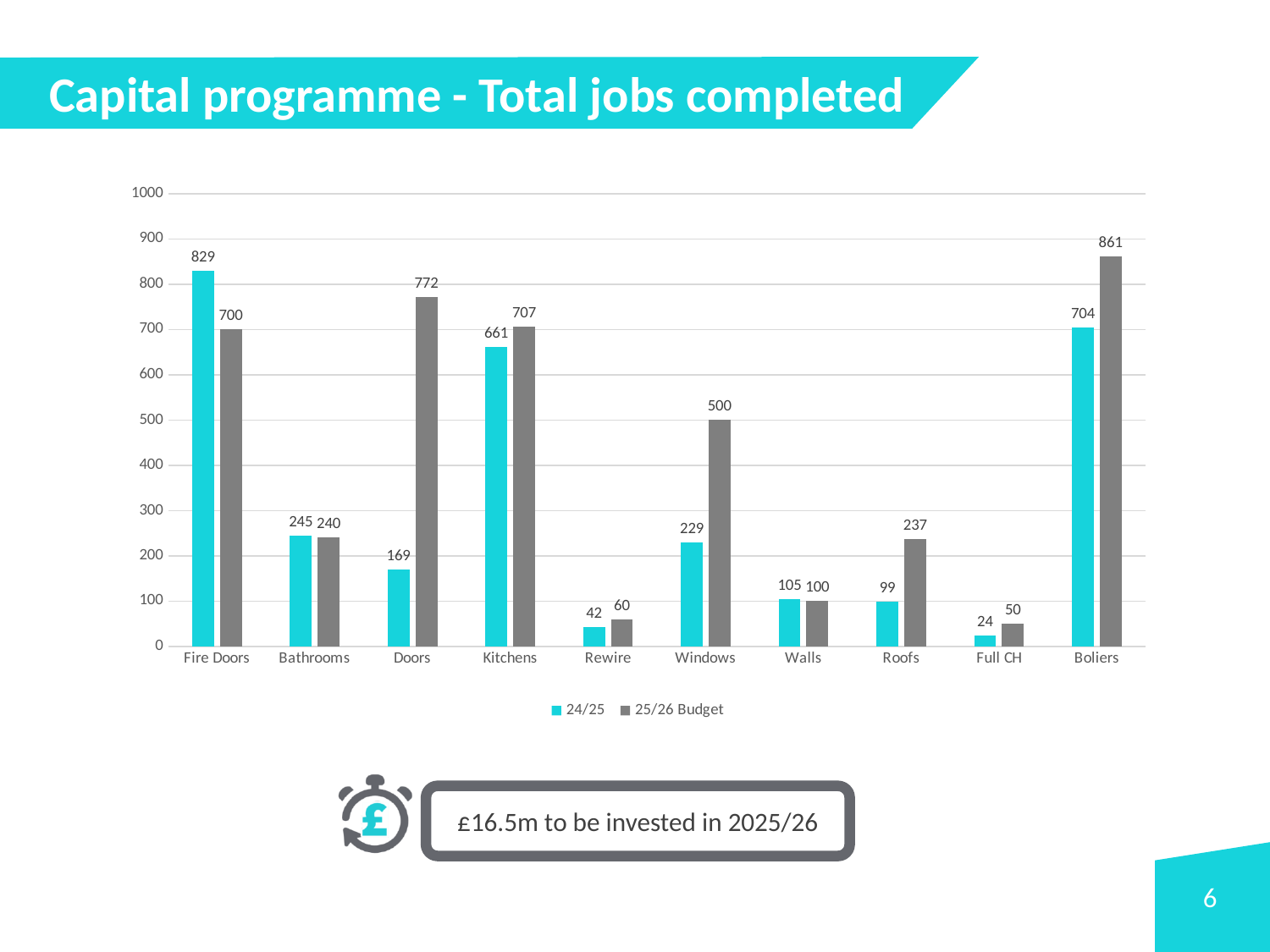
Which category has the highest 25/26 Budget value? Boliers What is the difference between the 25/26 Budget and 24/25 values for Doors? 603 Which is larger for Kitchens, the 24/25 value or the 25/26 Budget value? 25/26 Budget What is the 25/26 Budget value for Windows? 500 What kind of chart is shown on the slide? bar chart Is the 24/25 value for Windows greater or less than 300? less Which category has the lowest 24/25 value? Full CH What is the 24/25 value for Fire Doors? 829 How many series does the legend list? 2 How many categories are shown on the x axis? 10 What is the 24/25 value for Full CH? 24 What is the title of the slide? Capital programme - Total jobs completed